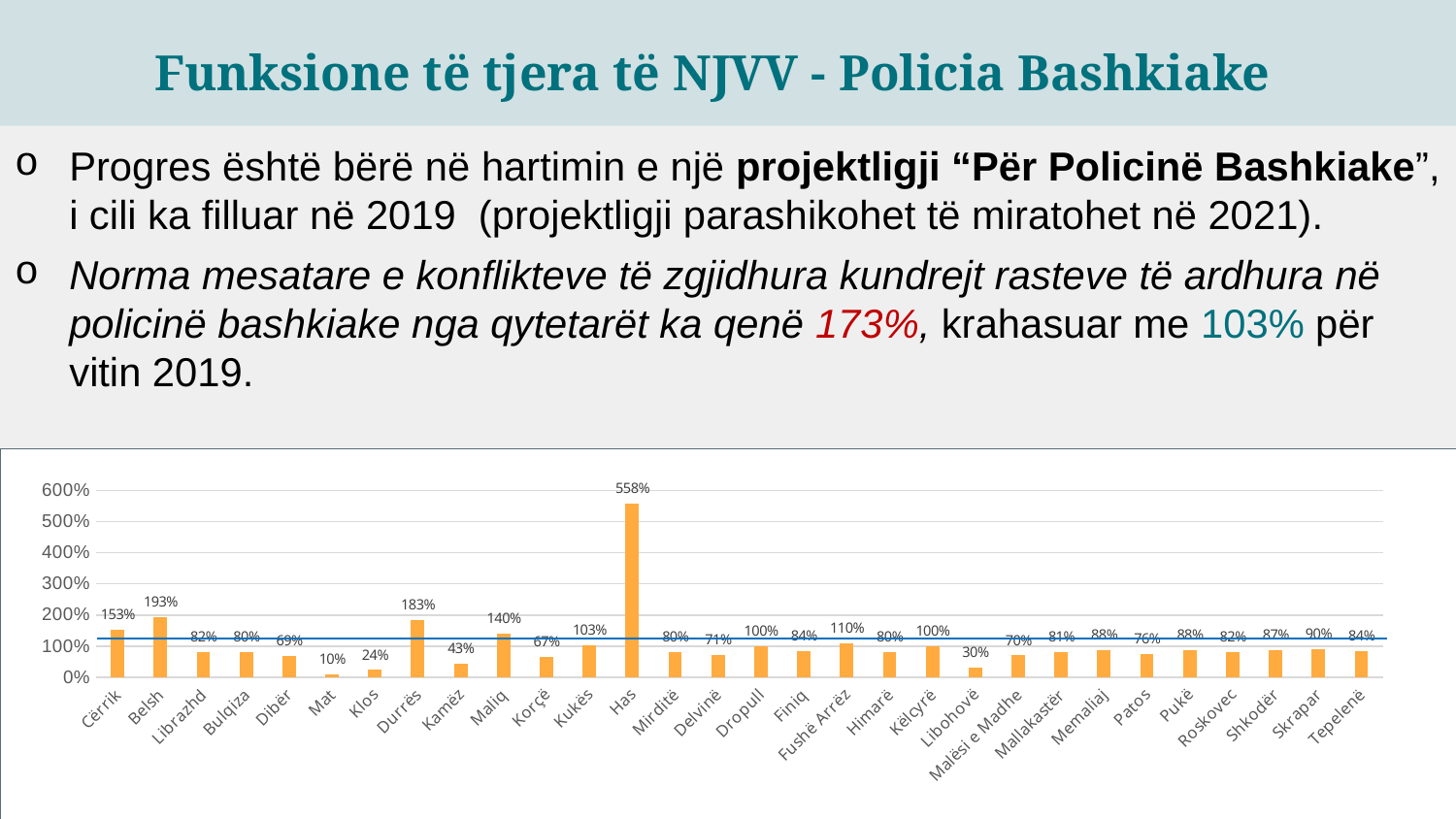
What kind of chart is shown on the slide? bar chart What is the highest value shown on the y axis of the chart? 600% Which has a larger value, Maliq or Kukës? Maliq Which municipality has the highest value in the bar chart? Has Is the value for Has greater or less than 500%? greater What is the value for Durrës in the bar chart? 183% What is the value for Libohovë in the bar chart? 30% What is the value for Has in the bar chart? 558% What is the value for Fushë Arrëz in the bar chart? 110% What is the difference between the values for Belsh and Cërrik? 40% Which municipality has the lowest value in the bar chart? Mat How many municipalities are shown on the x axis of the bar chart? 30